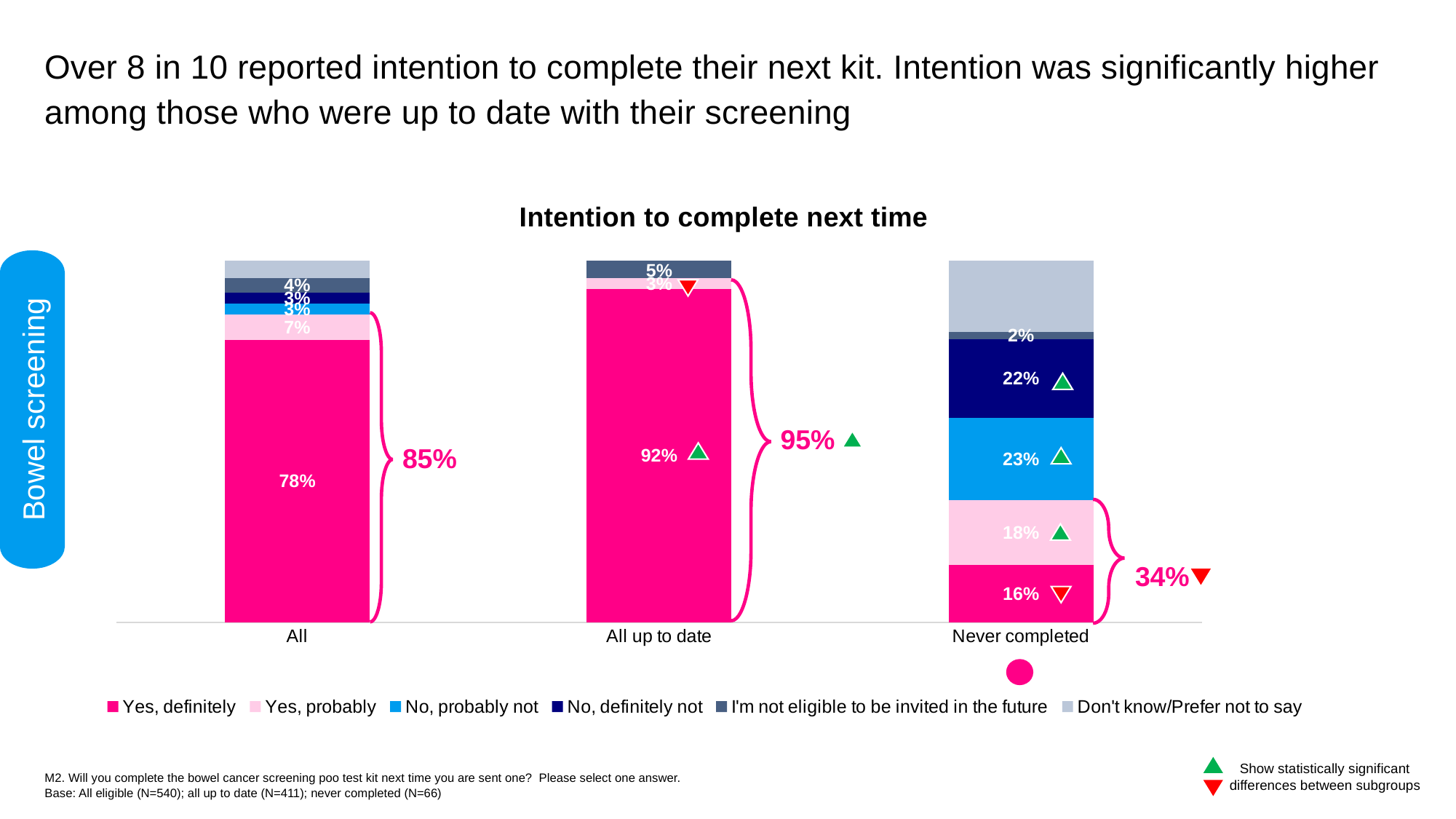
How many percentage points higher is 'Yes, definitely' for 'All up to date' than for 'All'? 14 percentage points What percentage of the 'Never completed' group answered 'No, probably not'? 23% How many groups are shown on the x axis? 3 Which group has the lowest 'Yes, definitely' percentage? Never completed What is the difference between the bracketed totals for 'All up to date' and 'All'? 10 percentage points What percentage of the 'All up to date' group said they are not eligible to be invited in the future? 5% What percentage of the 'All' group answered 'Yes, definitely'? 78% What is the combined 'Yes' percentage shown by the bracket for the 'Never completed' group? 34% Which group has the highest 'Yes, definitely' percentage? All up to date What percentage of the 'All up to date' group answered 'Yes, definitely'? 92% How many series does the legend list? 6 Which is larger: the 'Yes, probably' share for 'Never completed' or for 'All'? Never completed